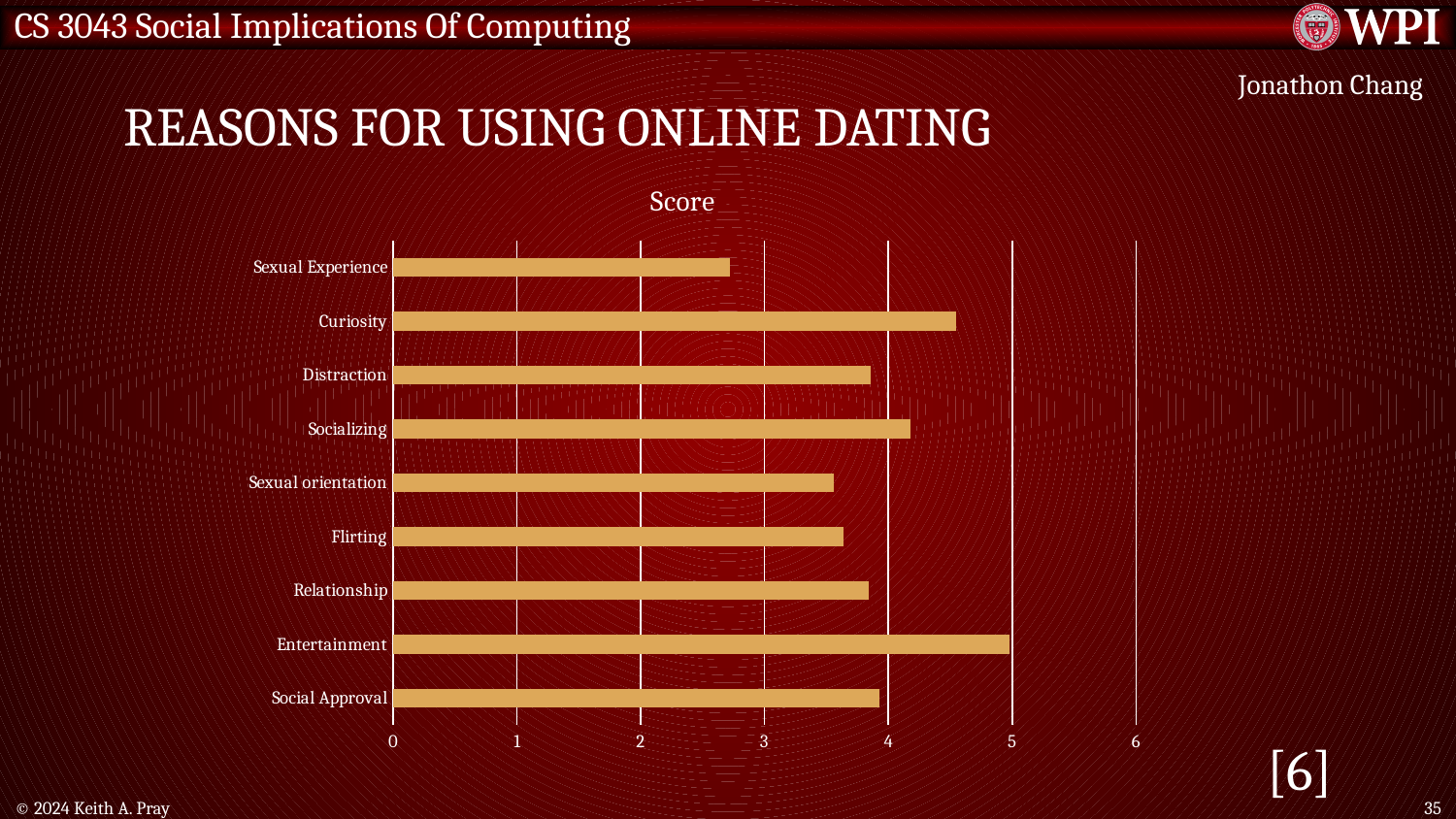
Which reason has the lowest score in the chart? Sexual Experience Which has a higher score, Entertainment or Sexual orientation? Entertainment Is the value for Flirting greater or less than 4? less Which has a higher score, Curiosity or Socializing? Curiosity Is the value for Socializing greater or less than 4? greater Which reason has the highest score in the chart? Entertainment What kind of chart is shown on the slide? bar chart Is the value for Sexual Experience greater or less than 3? less How many categories (reasons) are plotted in the chart? 9 What is the title of the chart? Score